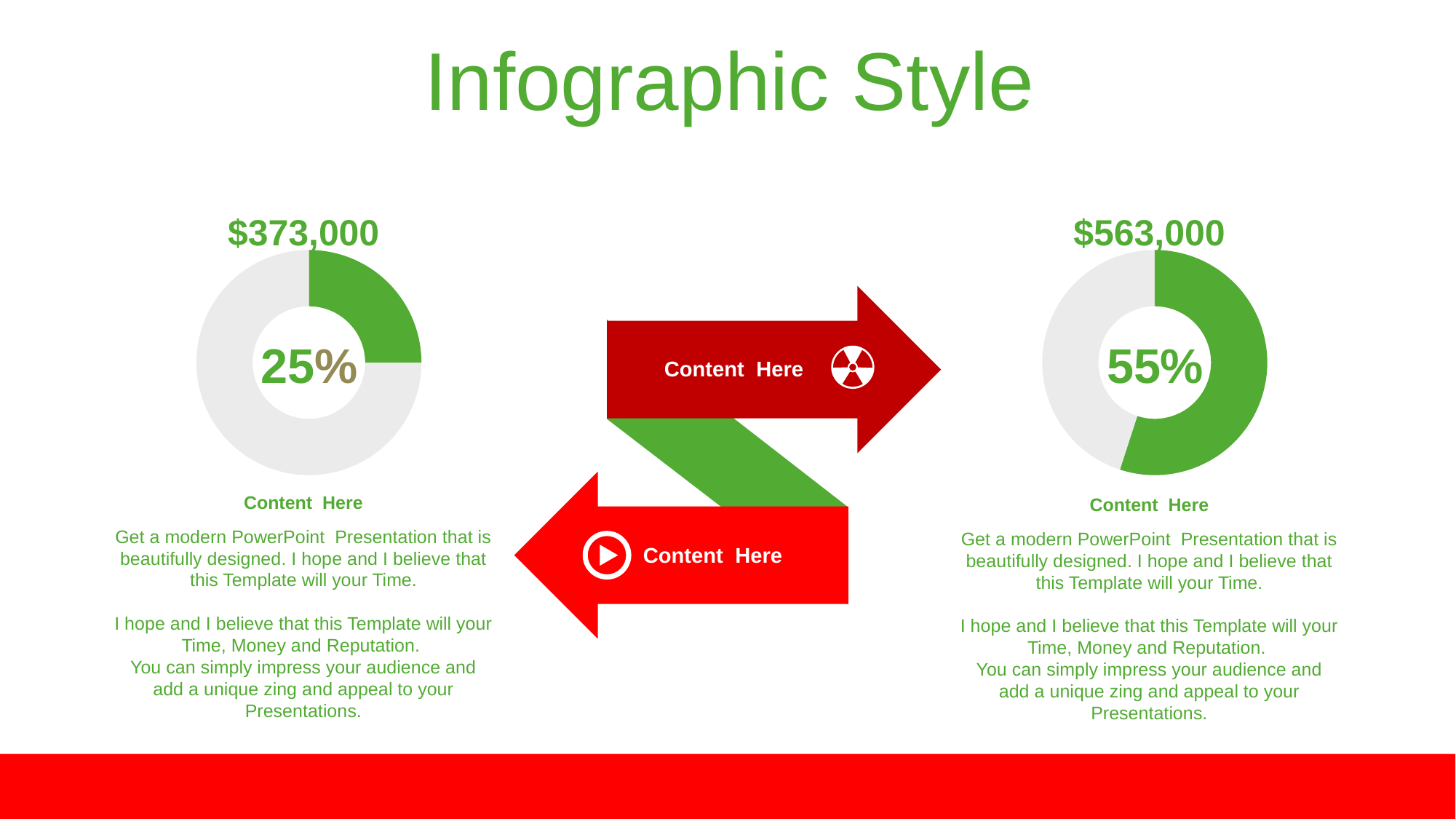
What dollar amount is printed above the left donut chart? $373,000 What percentage is shown in the centre of the right donut chart? 55% Is the green filled share of the right donut chart greater or less than 50%? greater Which donut chart shows the larger percentage, the left one or the right one? The right one What colour is the filled portion of the donut charts? Green How many donut charts are on the slide? 2 What kind of chart is shown on the left side of the slide? Donut chart What percentage is shown in the centre of the left donut chart? 25% What dollar amount is printed above the right donut chart? $563,000 What is the difference between the dollar amounts above the right and left donut charts? $190,000 Is the green filled share of the left donut chart greater or less than 50%? less What is the difference in percentage points between the right donut chart (55%) and the left donut chart (25%)? 30 percentage points